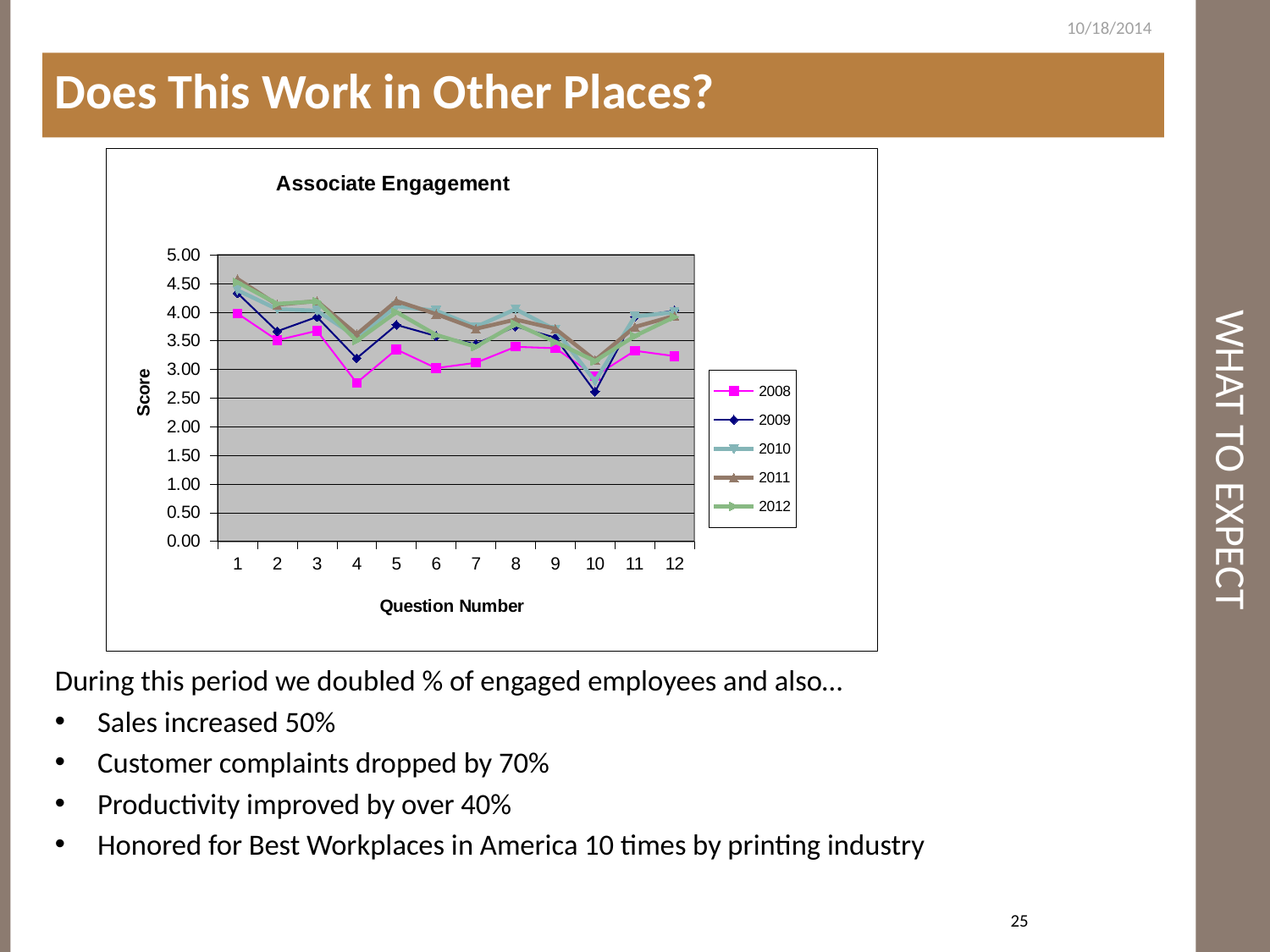
At which question number does the 2009 series reach its highest value? 1 How many series does the legend list? 5 Is the 2009 value for question 1 greater or less than 4.00? greater Is the 2009 value for question 10 greater or less than 3.00? less Is the 2008 value for question 4 greater or less than 3.00? less What is the label of the y axis? Score At which question number does the 2009 series reach its lowest value? 10 What kind of chart is shown on the slide? line chart What is the title of the chart? Associate Engagement How many question numbers are plotted along the x axis? 12 For question 4, which series has the larger value, 2008 or 2009? 2009